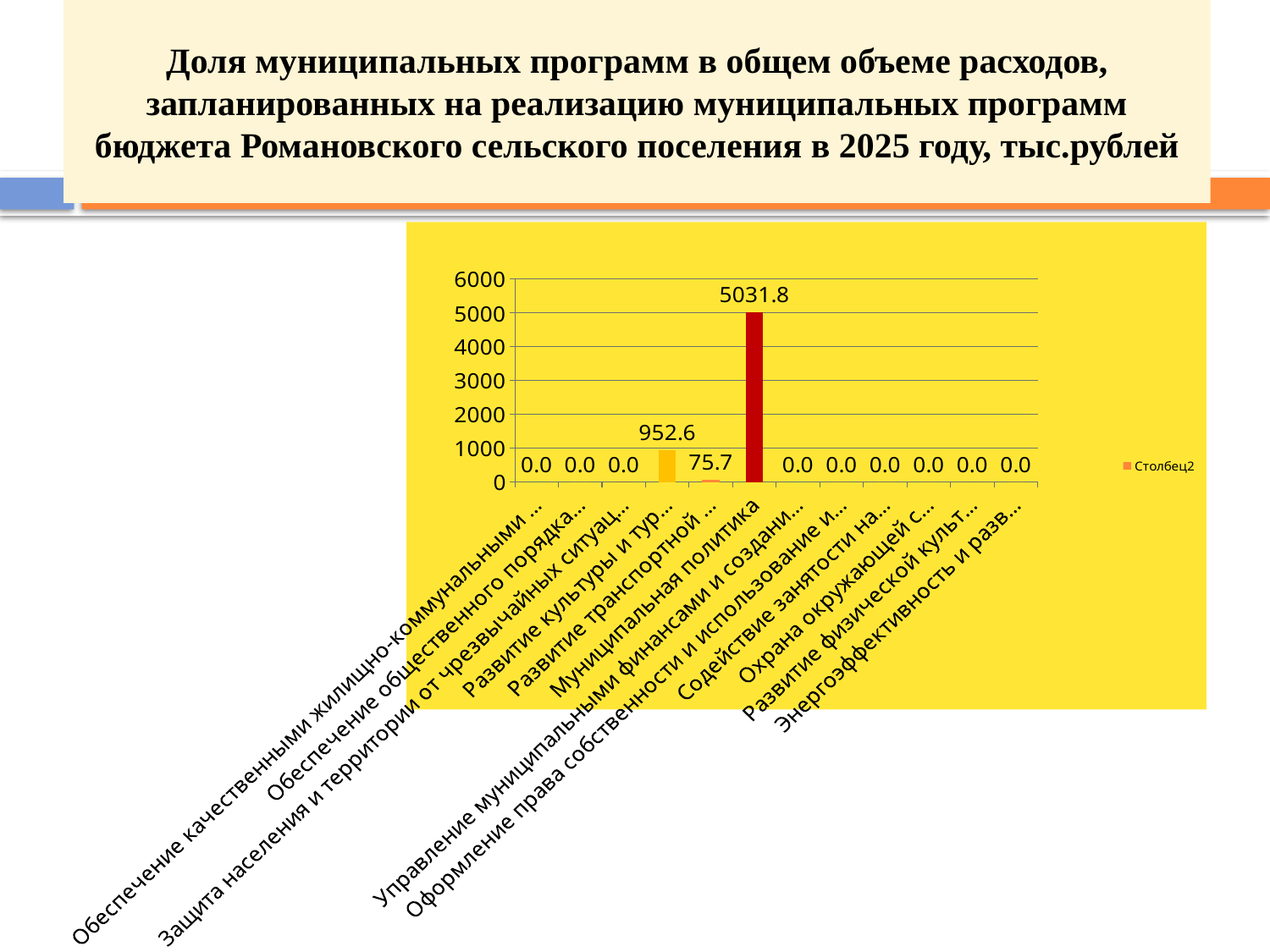
How many categories are shown on the x axis? 12 Is the value for Муниципальная политика greater or less than 5000? greater How many categories have a value of 0.0? 9 What is the value for Развитие транспортной ...? 75.7 What is the difference between the values for Муниципальная политика and Развитие культуры и тур...? 4079.2 What is the value for Муниципальная политика? 5031.8 What is the value for Развитие культуры и тур...? 952.6 Which category has the highest value? Муниципальная политика Which is larger, the value for Развитие культуры и тур... or the value for Развитие транспортной ...? Развитие культуры и тур... What kind of chart is shown on the slide? Bar chart What is the difference between the values for Развитие культуры и тур... and Развитие транспортной ...? 876.9 How many series does the legend list? 1